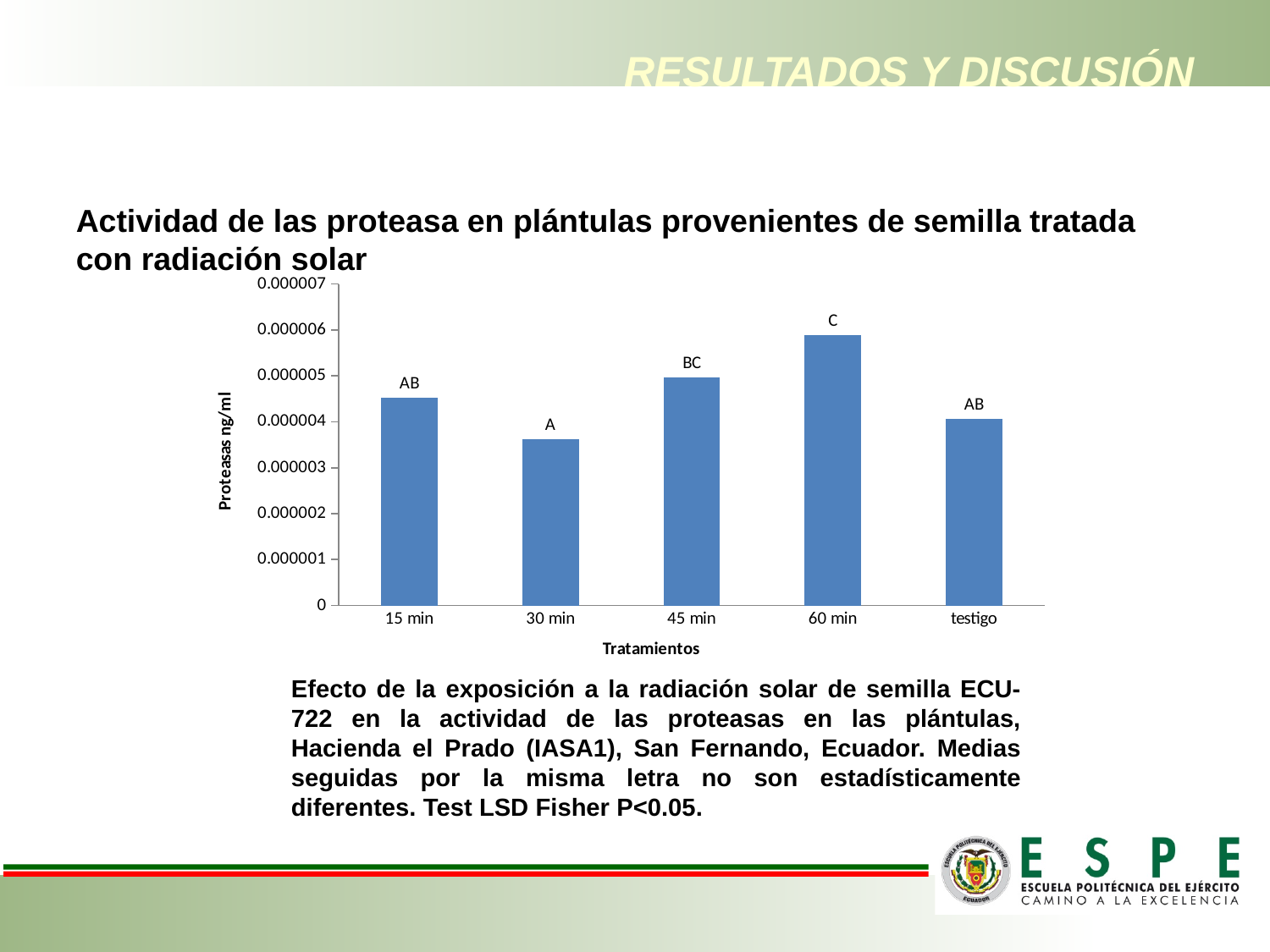
Which has a higher protease value, 45 min or testigo? 45 min How many treatment categories are plotted on the x axis? 5 Which treatment has the lowest protease activity? 30 min What is the label of the y axis? Proteasas ng/ml What letter label appears above the 60 min bar? C Is the value for 30 min greater or less than 0.000004? less Which treatment has the highest protease activity? 60 min What kind of chart is shown on the slide? bar chart Is the value for testigo greater or less than 0.000005? less Is the value for 60 min greater or less than 0.000005? greater Which has a higher protease value, 60 min or 30 min? 60 min